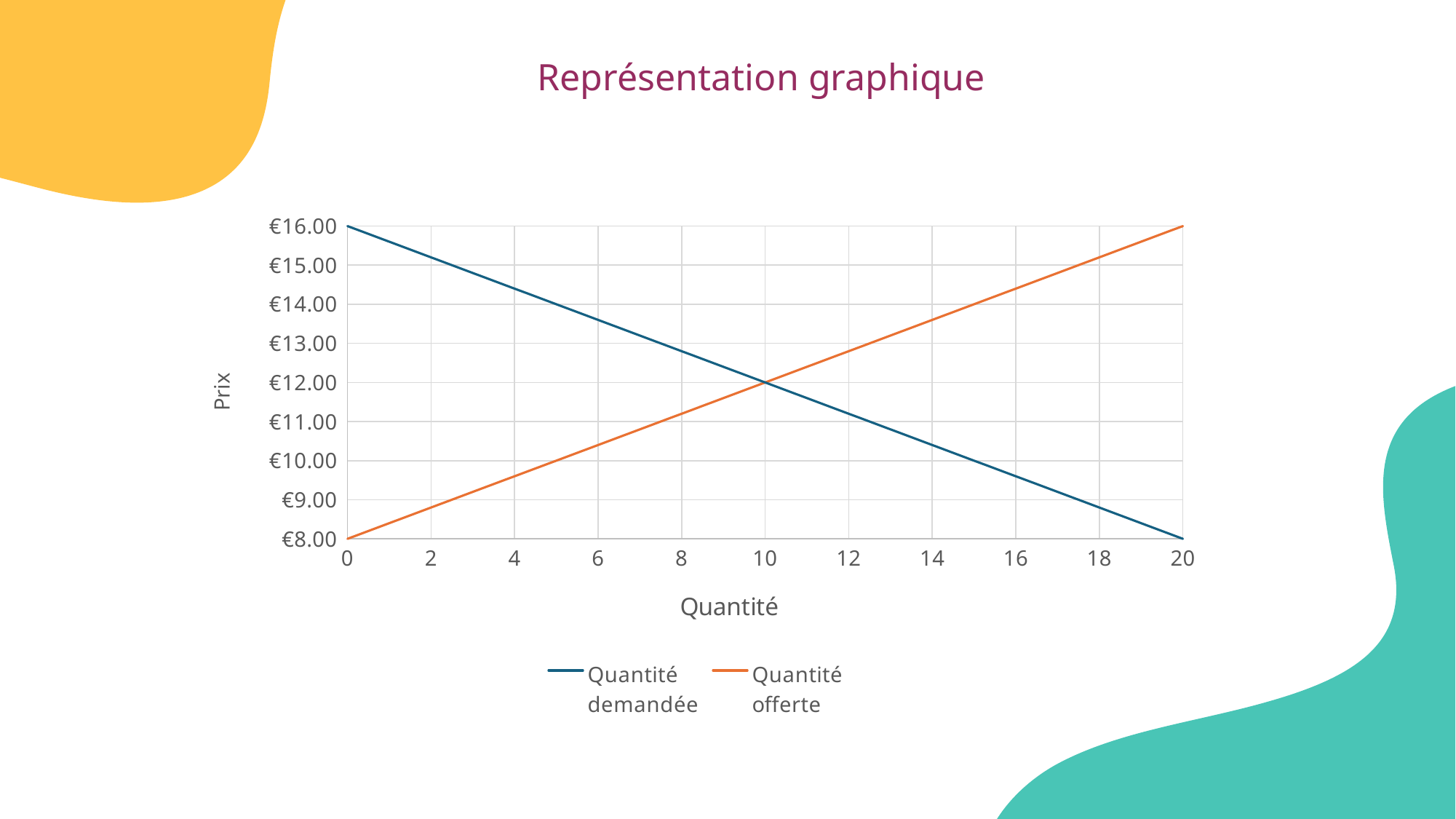
Does the Quantité demandée line rise or fall as quantity increases? fall What is the price on the Quantité demandée line at a quantity of 20? €8.00 How many series does the legend list? 2 What is the price on the Quantité demandée line at a quantity of 0? €16.00 Does the Quantité offerte line rise or fall as quantity increases? rise At what price do the Quantité demandée and Quantité offerte lines cross? €12.00 At what quantity do the Quantité demandée and Quantité offerte lines cross? 10 Is the price on the Quantité offerte line at a quantity of 4 greater or less than €10.00? less At a quantity of 16, which line shows the higher price, Quantité demandée or Quantité offerte? Quantité offerte What is the title of the vertical axis? Prix What is the price on the Quantité offerte line at a quantity of 0? €8.00 What kind of chart is shown on the slide? line chart